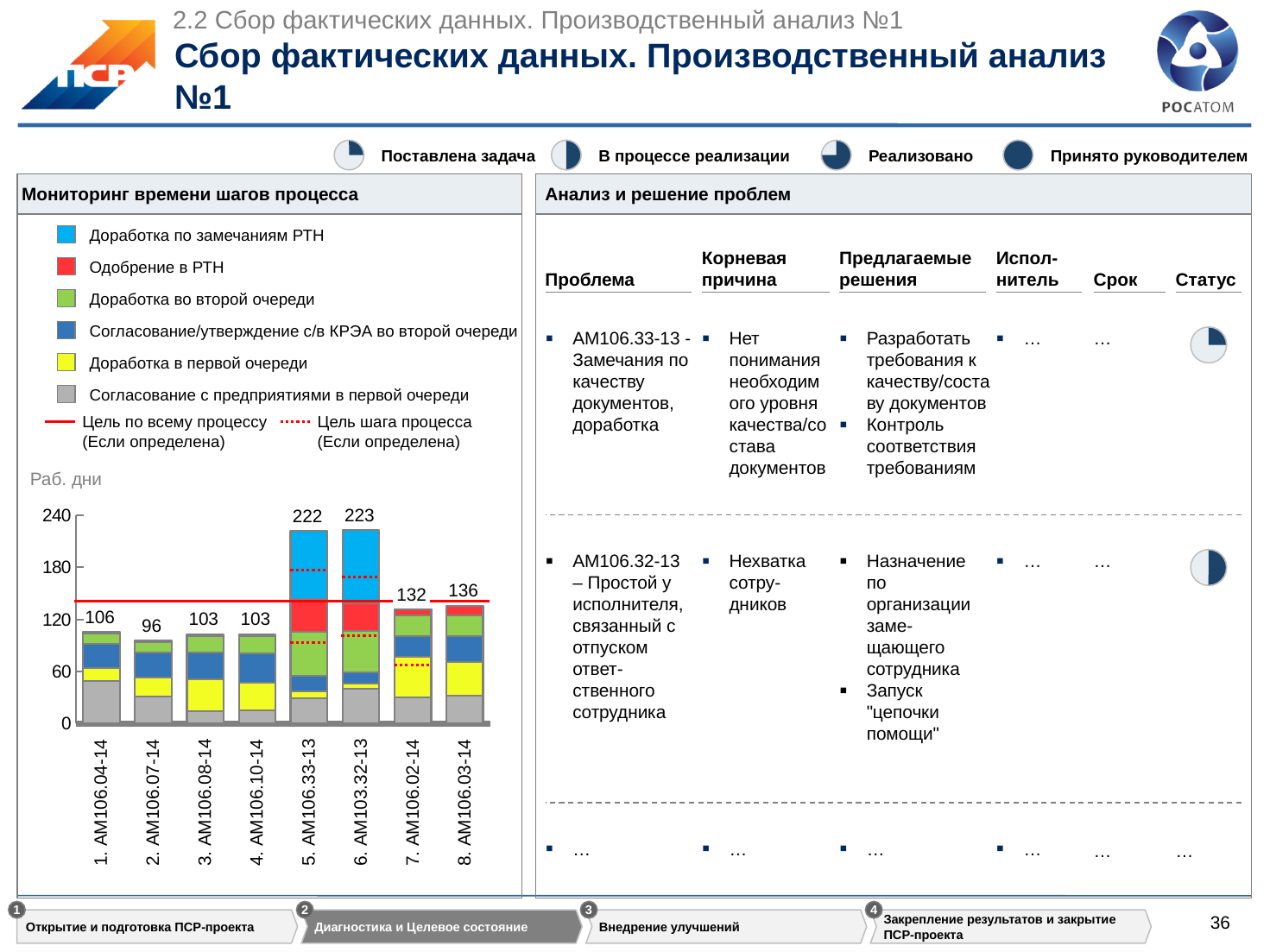
What unit is shown on the y axis of the chart? Раб. дни Which category has the highest total in the chart? 6. АМ103.32-13 What is the total value shown for bar 5. АМ106.33-13? 222 What is the difference between the totals for 8. АМ106.03-14 and 7. АМ106.02-14? 4 What is the total value shown for bar 2. АМ106.07-14? 96 Is the total for 6. АМ103.32-13 greater or less than 180? greater Which has a larger total, 5. АМ106.33-13 or 7. АМ106.02-14? 5. АМ106.33-13 How many categories (bars) are shown on the x axis of the chart? 8 Which category has the lowest total in the chart? 2. АМ106.07-14 What type of chart is shown under "Мониторинг времени шагов процесса"? Stacked bar chart What is the total value shown for bar 8. АМ106.03-14? 136 What is the difference between the totals for 1. АМ106.04-14 and 2. АМ106.07-14? 10